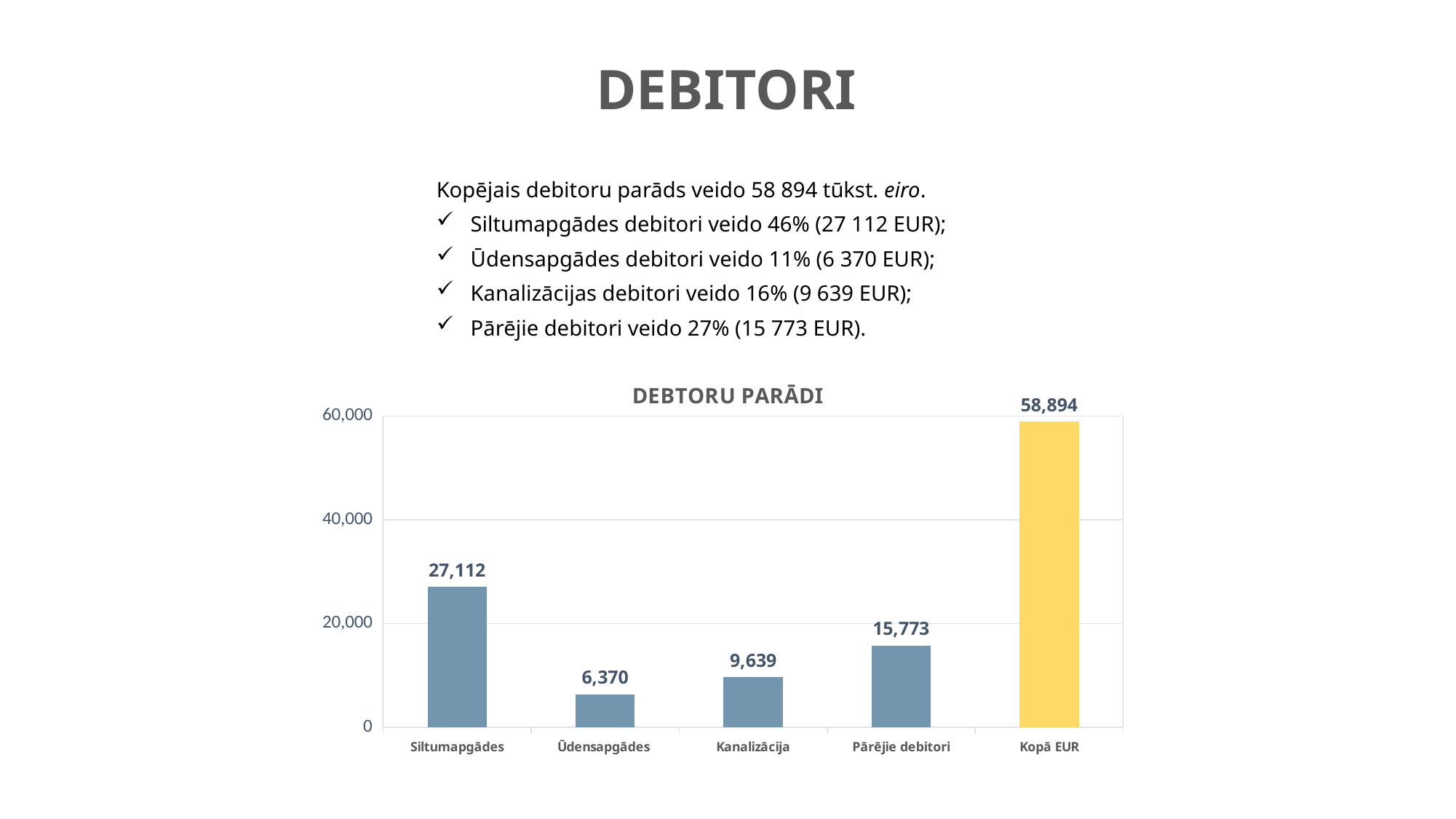
What is the difference between the values for Siltumapgādes and Pārējie debitori? 11,339 What is the value for Siltumapgādes? 27,112 What is the value for Pārējie debitori? 15,773 What is the value for Kopā EUR? 58,894 Which category has the highest value? Kopā EUR What is the value for Ūdensapgādes? 6,370 What is the title of the chart? DEBTORU PARĀDI What is the value for Kanalizācija? 9,639 What kind of chart is shown? Bar chart Which is larger, the value for Kanalizācija or the value for Ūdensapgādes? Kanalizācija How many categories are shown on the x axis? 5 Which category has the lowest value? Ūdensapgādes